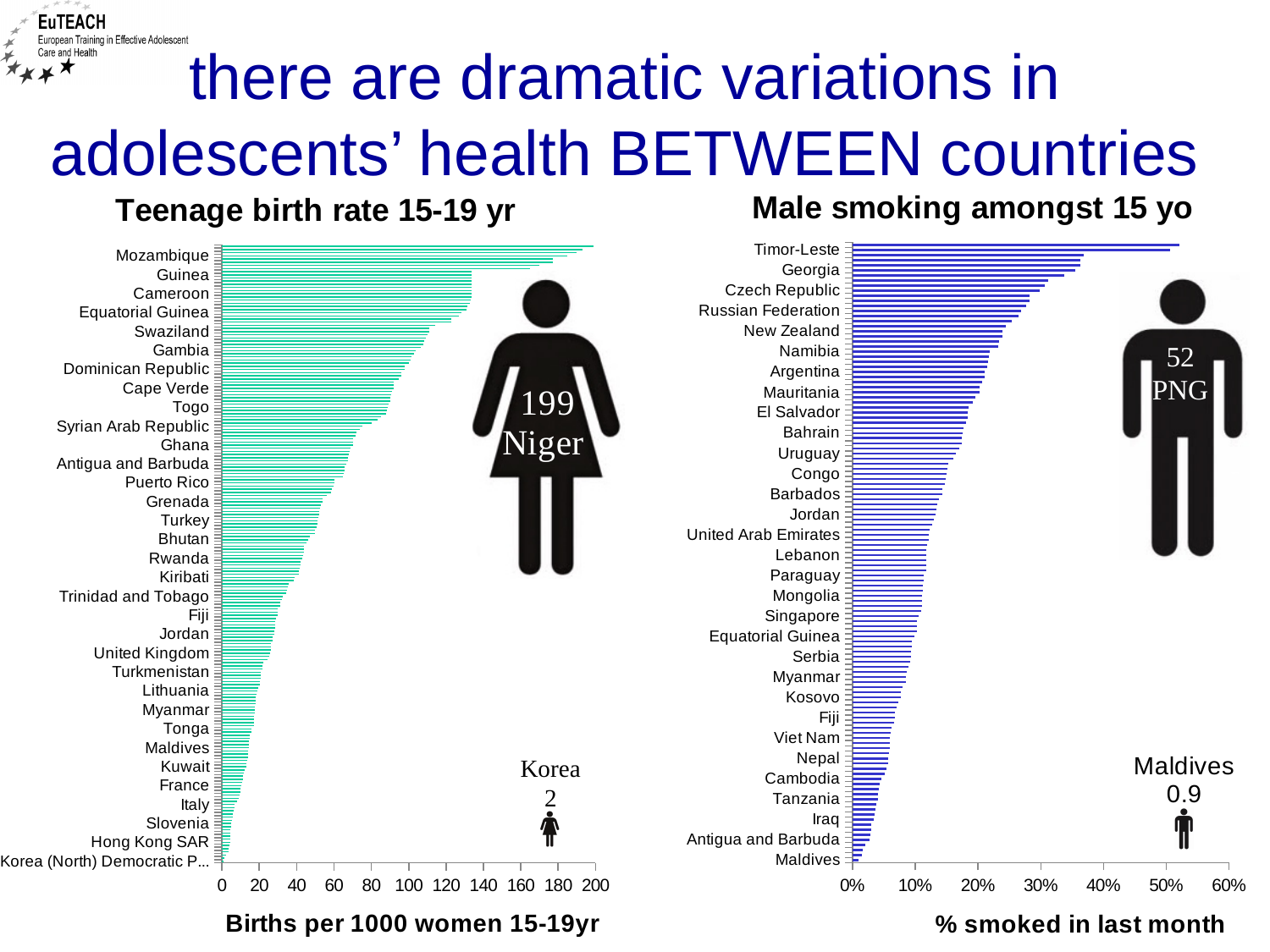
On the Male smoking amongst 15 yo chart, is the value for Timor-Leste greater or less than 40%? greater On the Male smoking amongst 15 yo chart, what value is annotated for Maldives? 0.9 On the Teenage birth rate 15-19 yr chart, which has the larger value, Mozambique or Ghana? Mozambique On the Teenage birth rate 15-19 yr chart, what is the difference between the annotated values for Niger and Korea? 197 On the Male smoking amongst 15 yo chart, what value is annotated for PNG? 52 On the Teenage birth rate 15-19 yr chart, what value is annotated for Korea? 2 On the Teenage birth rate 15-19 yr chart, is the value for Italy greater or less than 20? less What type of chart is used for the Teenage birth rate 15-19 yr chart? bar chart On the Male smoking amongst 15 yo chart, do the bars get longer or shorter going down the chart from Timor-Leste to Maldives? shorter On the Teenage birth rate 15-19 yr chart, what value is annotated for Niger? 199 What is the x-axis title of the Male smoking amongst 15 yo chart? % smoked in last month On the Male smoking amongst 15 yo chart, which has the larger value, Georgia or Fiji? Georgia